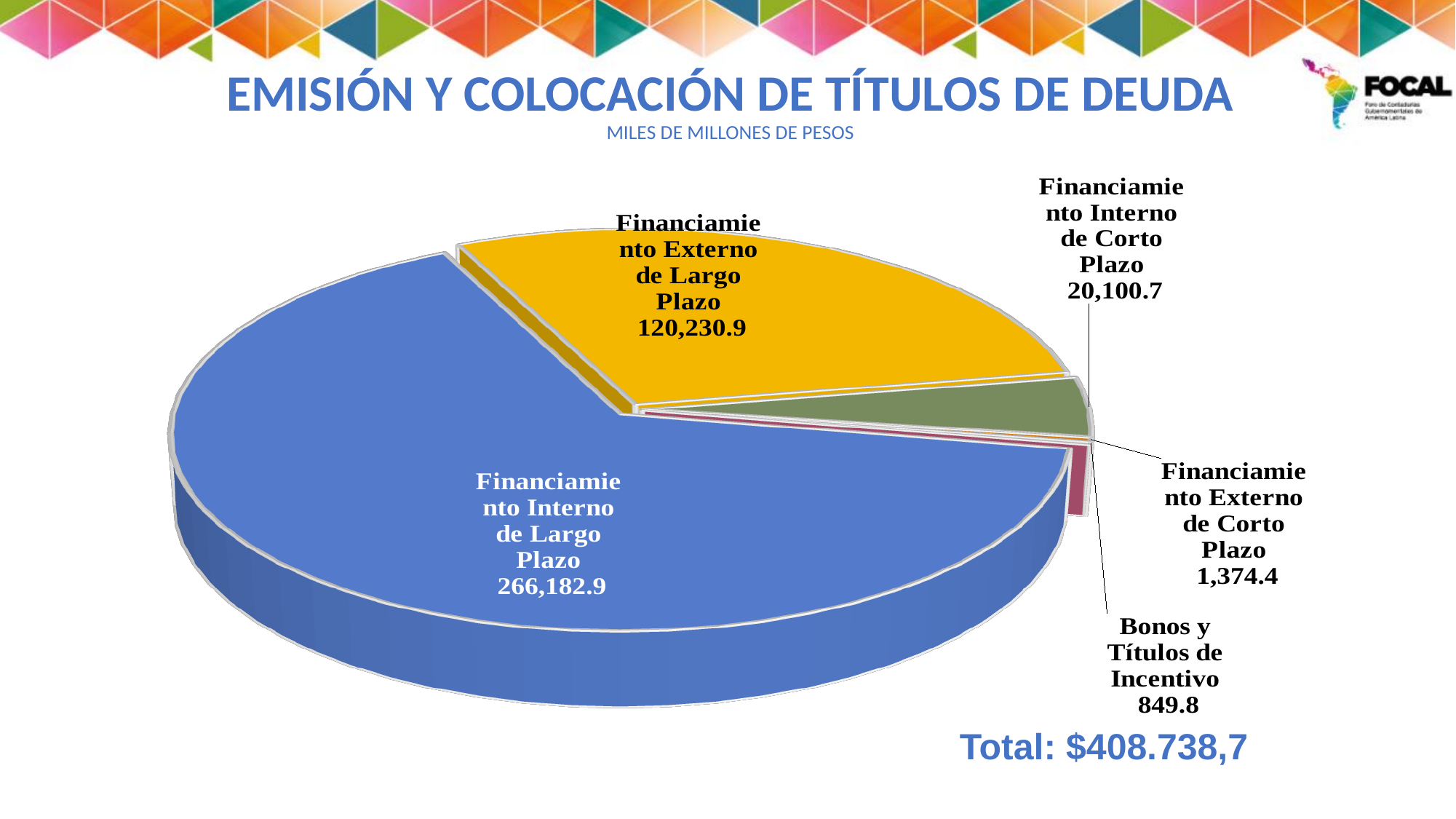
What is the difference between Financiamiento Interno de Largo Plazo and Financiamiento Externo de Largo Plazo? 145,952.0 What is the value for Bonos y Títulos de Incentivo? 849.8 Which category has the largest slice of the pie? Financiamiento Interno de Largo Plazo What kind of chart is shown on the slide? Pie chart What unit is stated in the subtitle of the chart? Miles de millones de pesos What total is printed on the slide for the pie chart? $408.738,7 What is the value for Financiamiento Externo de Largo Plazo? 120,230.9 Which is larger, Financiamiento Interno de Corto Plazo or Financiamiento Externo de Corto Plazo? Financiamiento Interno de Corto Plazo Which category has the smallest slice of the pie? Bonos y Títulos de Incentivo How many slices does the pie chart have? 5 What is the value for Financiamiento Interno de Largo Plazo? 266,182.9 What is the value for Financiamiento Interno de Corto Plazo? 20,100.7